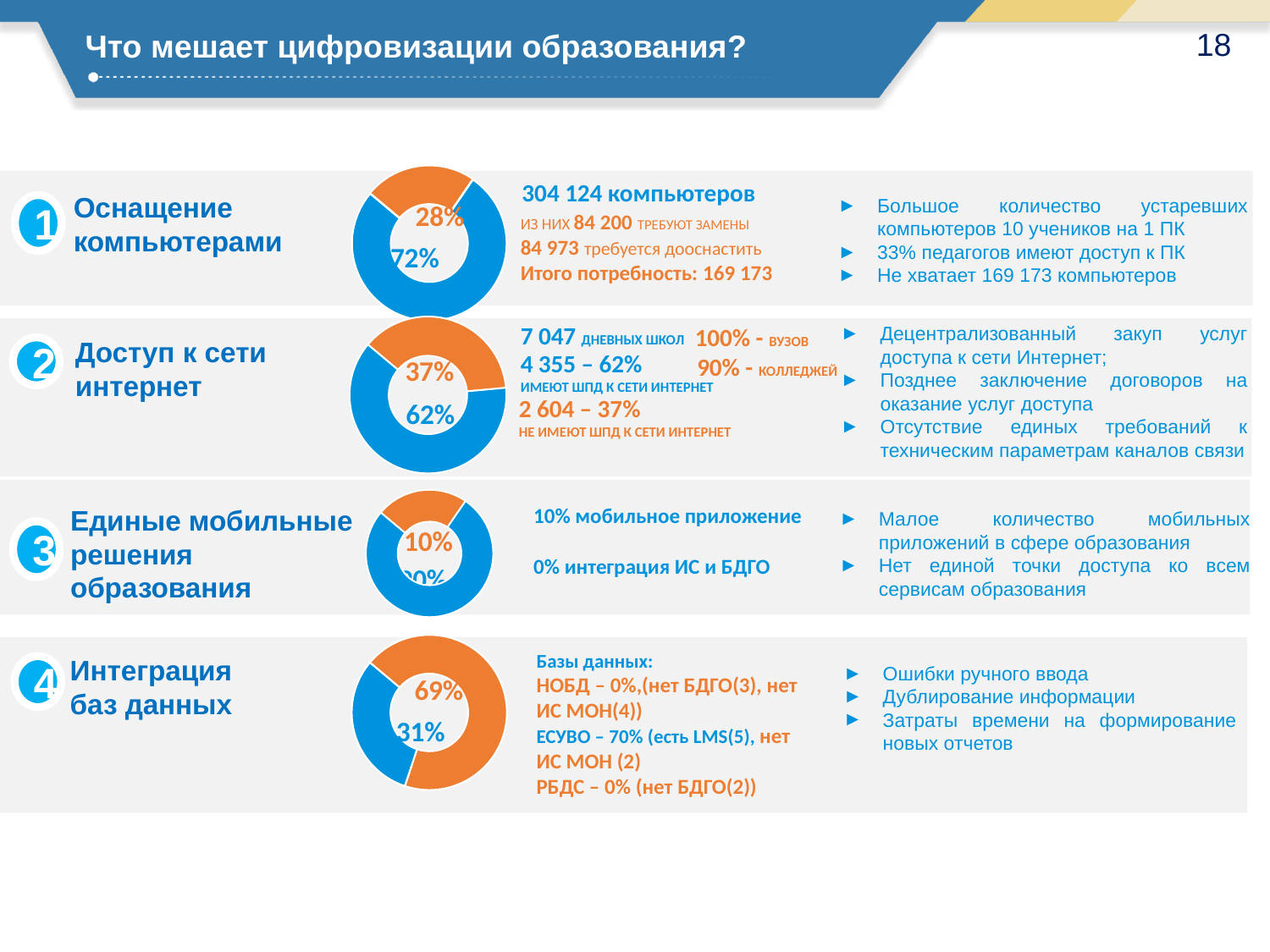
In the third-row chart (Единые мобильные решения образования), what value is shown on the orange segment? 10% In the fourth-row chart (Интеграция баз данных), what value is shown on the orange segment? 69% In the first-row chart (Оснащение компьютерами), what value is shown on the orange segment? 28% In the fourth-row chart (Интеграция баз данных), what value is shown on the blue segment? 31% In the second-row chart (Доступ к сети интернет), what value is shown on the orange segment? 37% In the fourth-row chart (Интеграция баз данных), which segment is larger, the orange one or the blue one? Orange In the second-row chart (Доступ к сети интернет), what value is shown on the blue segment? 62% In the second-row chart (Доступ к сети интернет), which segment is larger, the blue one or the orange one? Blue How many segments does the first-row chart (Оснащение компьютерами) have? 2 In the first-row chart (Оснащение компьютерами), what value is shown on the blue segment? 72% What kind of chart is shown next to "Оснащение компьютерами" in the first row? Donut (pie) chart In the first-row chart (Оснащение компьютерами), what is the difference between the blue and orange segment values? 44%